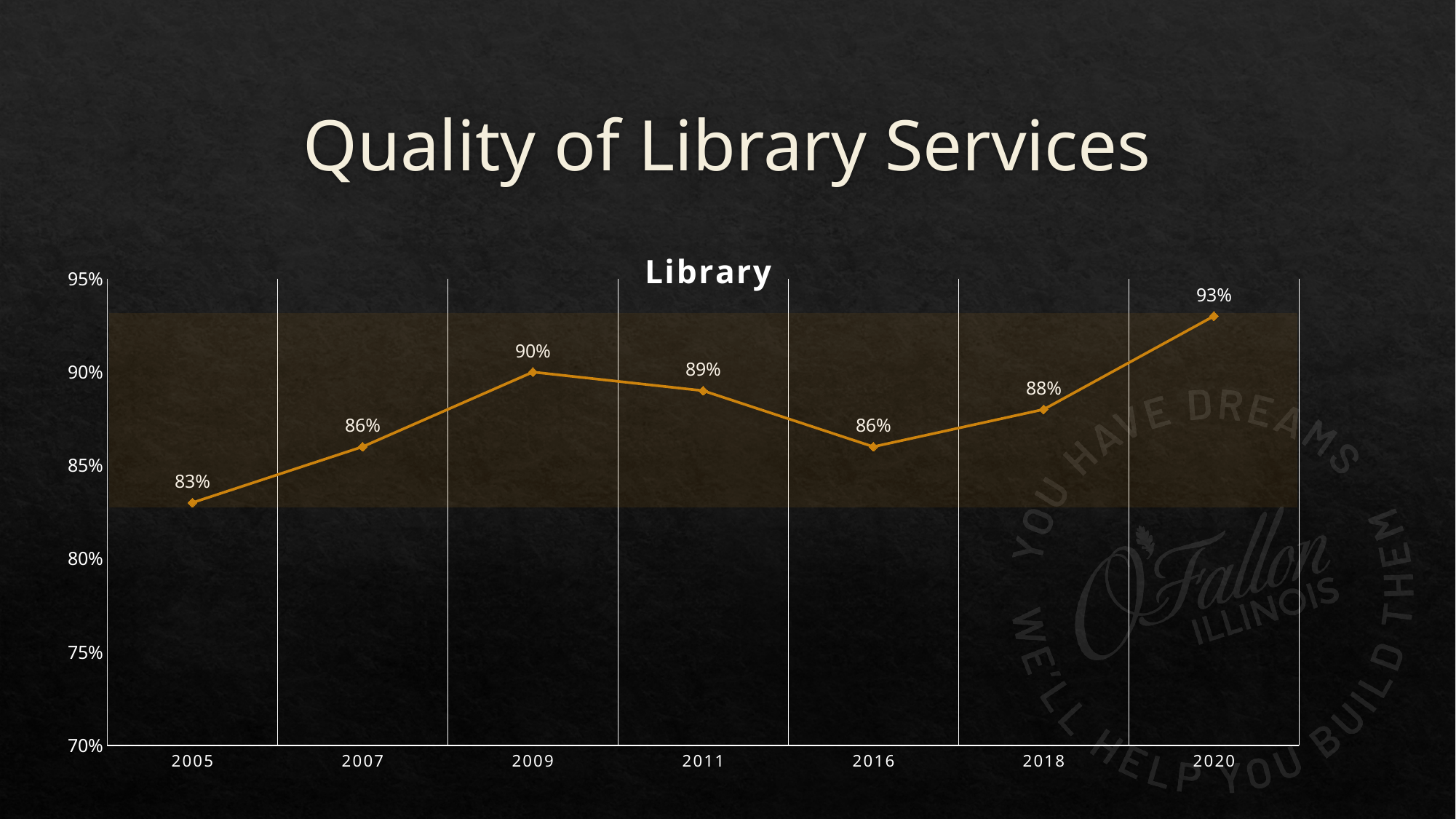
Which is larger, the value for 2009 or the value for 2011? 2009 Which year has the lowest value? 2005 What is the difference between the values for 2020 and 2005? 10% What kind of chart is shown? Line chart What is the value for 2020? 93% What is the value for 2005? 83% Does the value rise or fall from 2016 to 2020? Rise What is the value for 2009? 90% What is the title of the chart? Library How many years are plotted on the chart? 7 What is the value for 2016? 86% Which year has the highest value? 2020